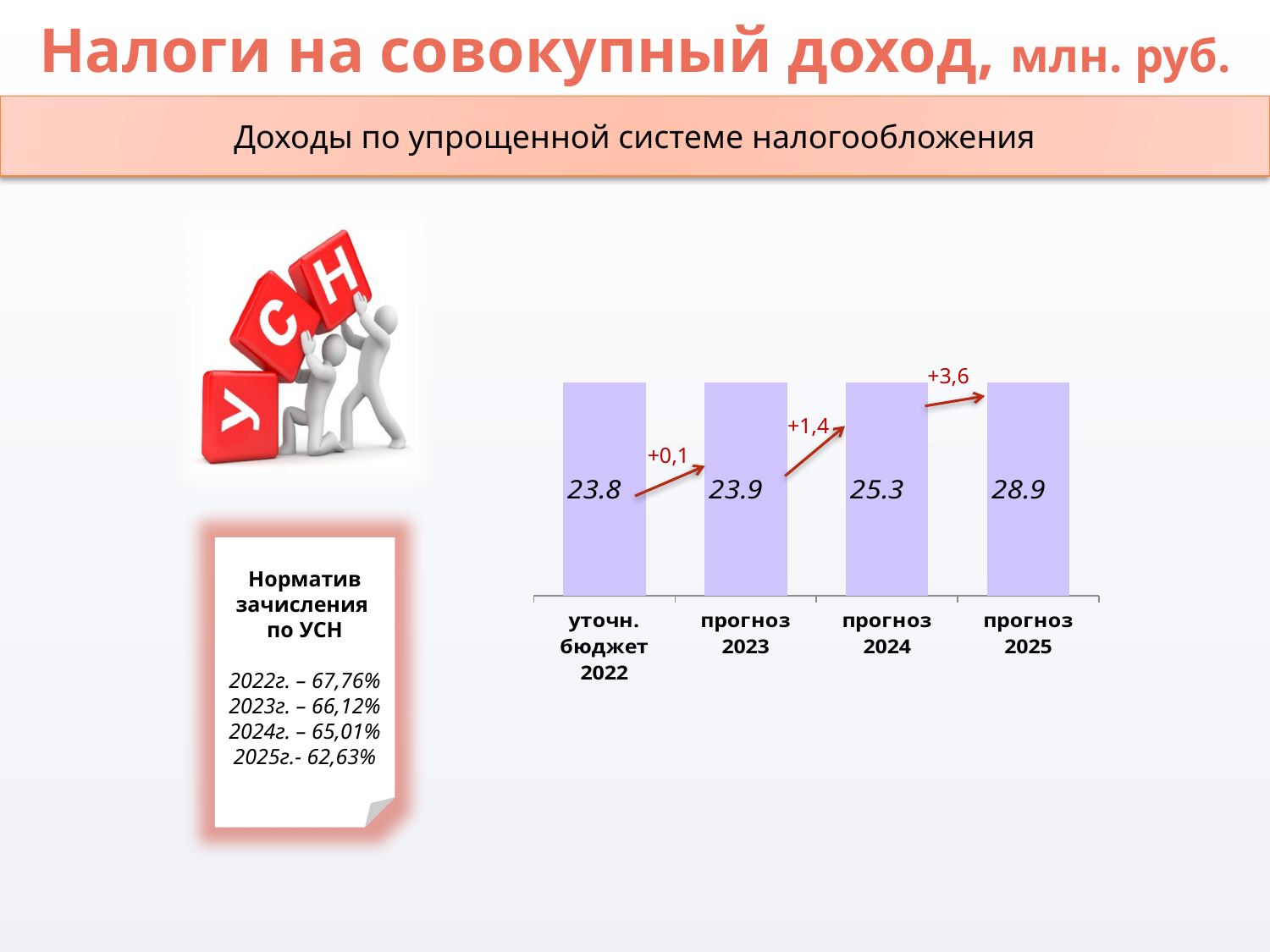
Which category has the lowest value? уточн. бюджет 2022 What is the difference between the values for прогноз 2025 and уточн. бюджет 2022? 5.1 What is the value for прогноз 2025? 28.9 What is the value for уточн. бюджет 2022? 23.8 What is the difference between the values for прогноз 2024 and прогноз 2023? 1.4 What is the value for прогноз 2024? 25.3 What is the value for прогноз 2023? 23.9 What kind of chart is shown on the slide? bar chart How many categories are shown in the chart? 4 Do the values rise or fall from уточн. бюджет 2022 to прогноз 2025? rise Which is larger, the value for прогноз 2025 or the value for прогноз 2024? прогноз 2025 Which category has the highest value? прогноз 2025